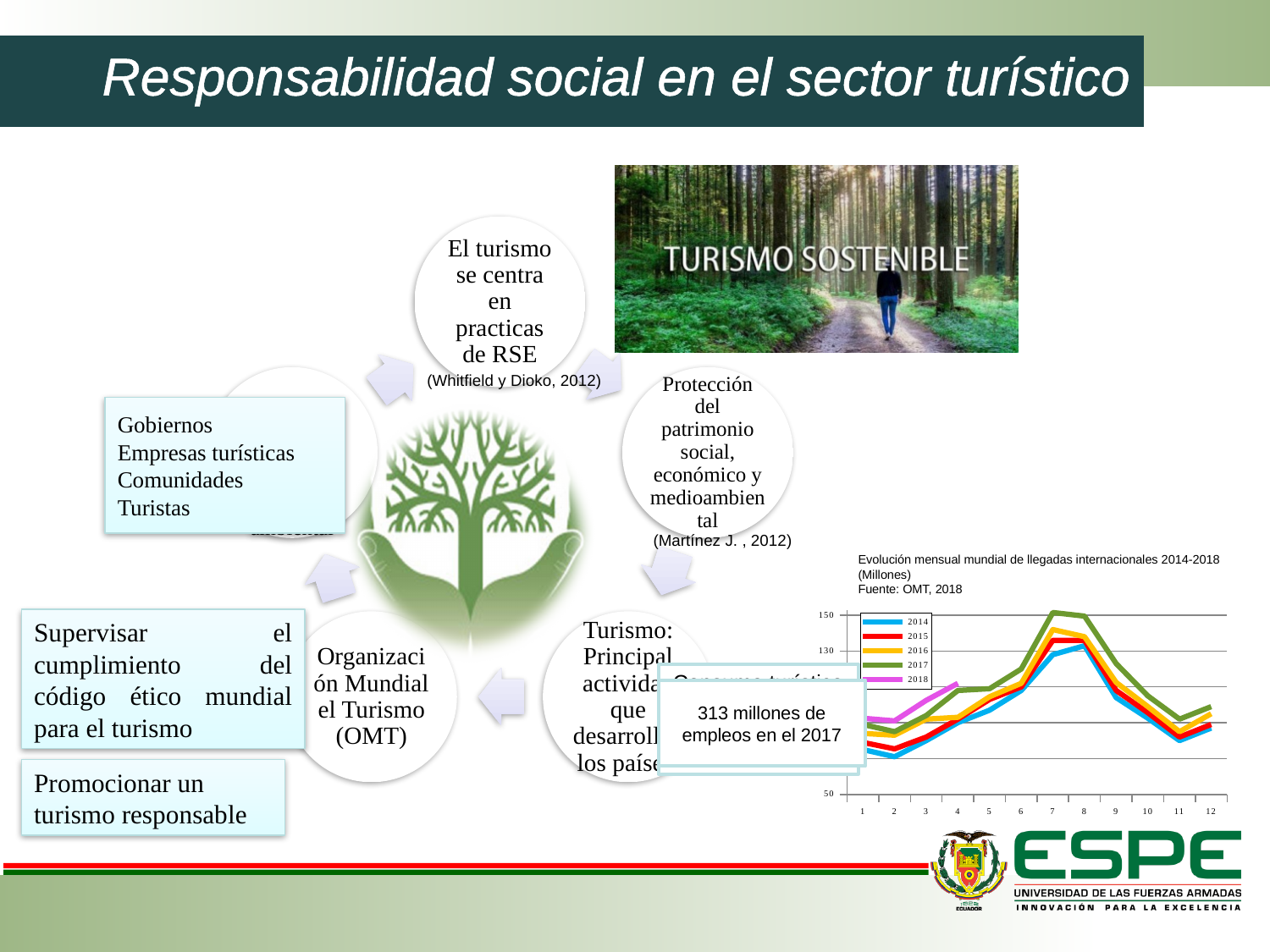
In the line chart, in which month does the 2017 series reach its highest value? 7 How many series does the legend of the line chart list? 5 In the line chart, do the values rise or fall from month 7 to month 12? fall What kind of chart is shown at the bottom right of the slide? line chart In the line chart, is the value for 2017 in month 7 greater or less than 130? greater In the line chart, which series is highest in month 7? 2017 Which years are listed in the legend of the line chart? 2014, 2015, 2016, 2017, 2018 How many months (points) are shown along the x axis of the line chart? 12 In the line chart, which series has the higher value in month 7, 2017 or 2014? 2017 What is the title of the line chart? Evolución mensual mundial de llegadas internacionales 2014-2018 (Millones) In the line chart, in which month does the 2014 series reach its lowest value? 2 In the line chart, is the value for 2014 in month 2 greater or less than 130? less